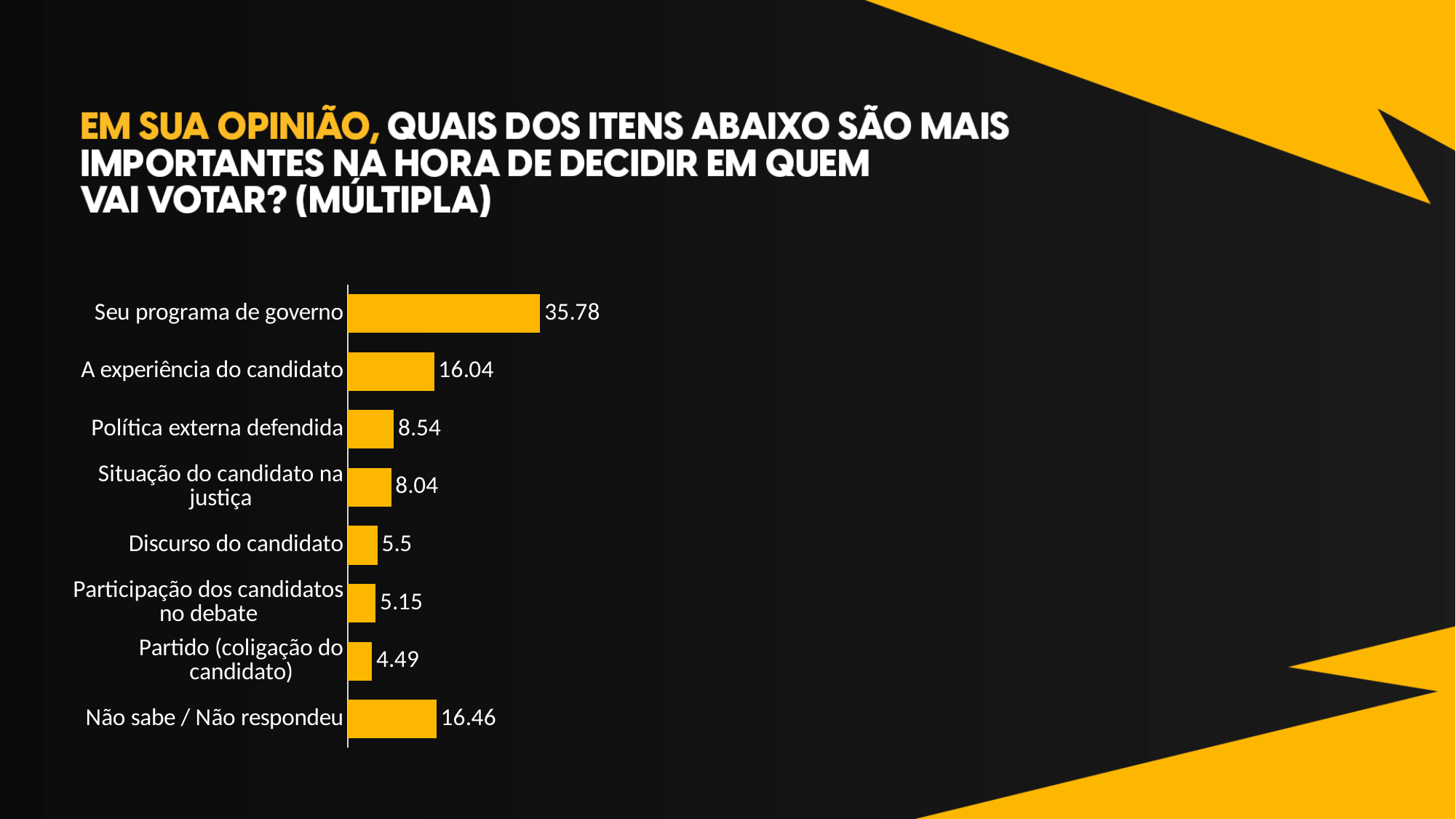
Which is larger: the value for "Não sabe / Não respondeu" or the value for "A experiência do candidato"? Não sabe / Não respondeu What is the difference between the values for "Política externa defendida" and "Situação do candidato na justiça"? 0.5 How many categories are shown in the chart? 8 What is the value for "Situação do candidato na justiça"? 8.04 What kind of chart is shown on the slide? Bar chart Which is larger: the value for "Discurso do candidato" or the value for "Participação dos candidatos no debate"? Discurso do candidato What is the value for "Seu programa de governo"? 35.78 Which category has the lowest value? Partido (coligação do candidato) What is the value for "Não sabe / Não respondeu"? 16.46 What is the value for "A experiência do candidato"? 16.04 What is the difference between the values for "Seu programa de governo" and "A experiência do candidato"? 19.74 Which category has the highest value? Seu programa de governo